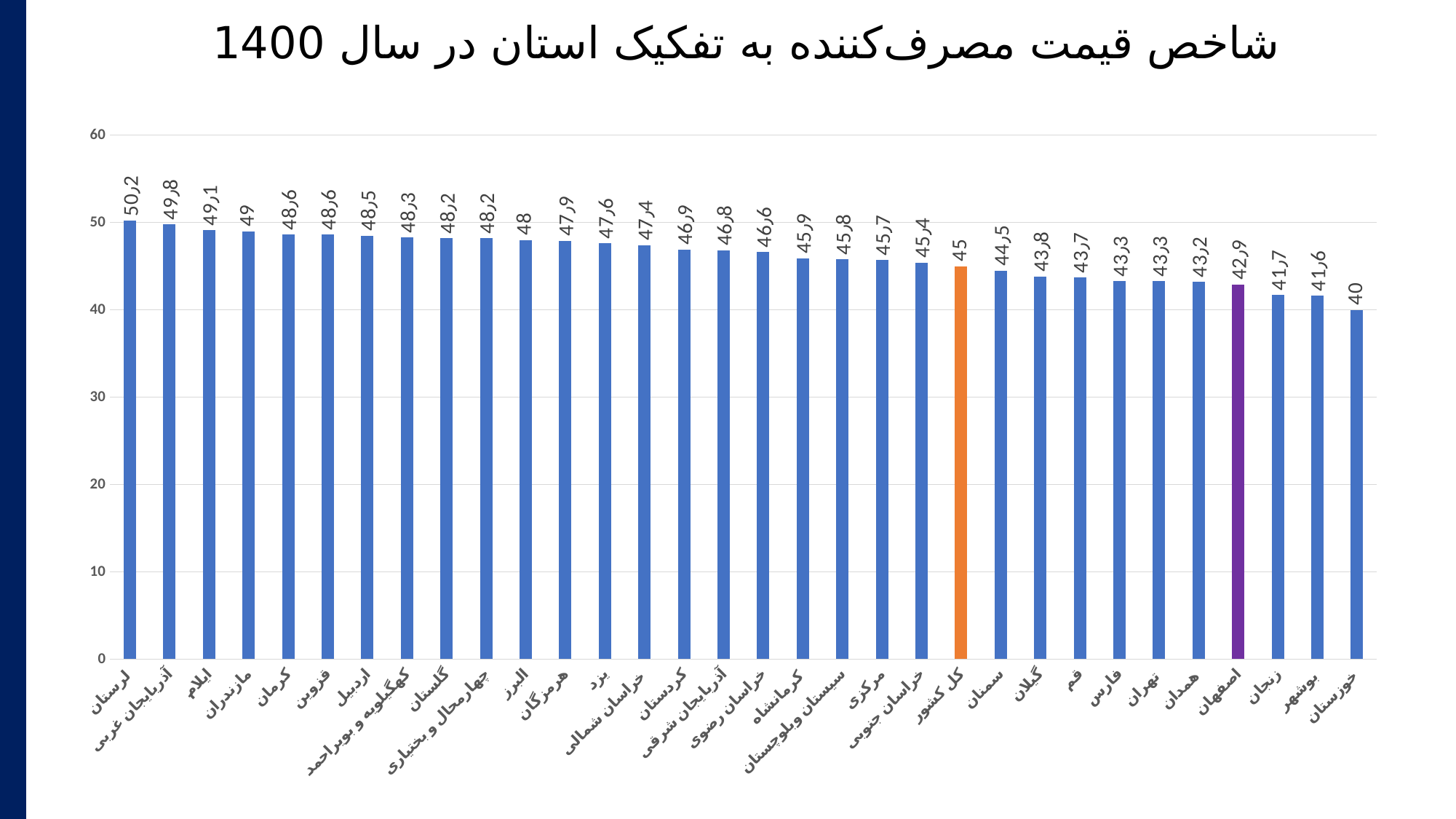
What is the value for اصفهان (the purple bar)? 42,9 Which category has the lowest value? خوزستان What is the value for لرستان? 50,2 What is the value for کل کشور (the orange bar)? 45 Which is larger, the value for گیلان or the value for زنجان? گیلان What is the value for تهران? 43,3 Which category has the highest value? لرستان Do the values generally rise or fall from left to right along the x axis? fall How many bars are plotted in the chart? 32 What is the difference between the values for لرستان and خوزستان? 10,2 What type of chart is shown on the slide? bar chart What is the title of the chart? شاخص قیمت مصرف‌کننده به تفکیک استان در سال 1400